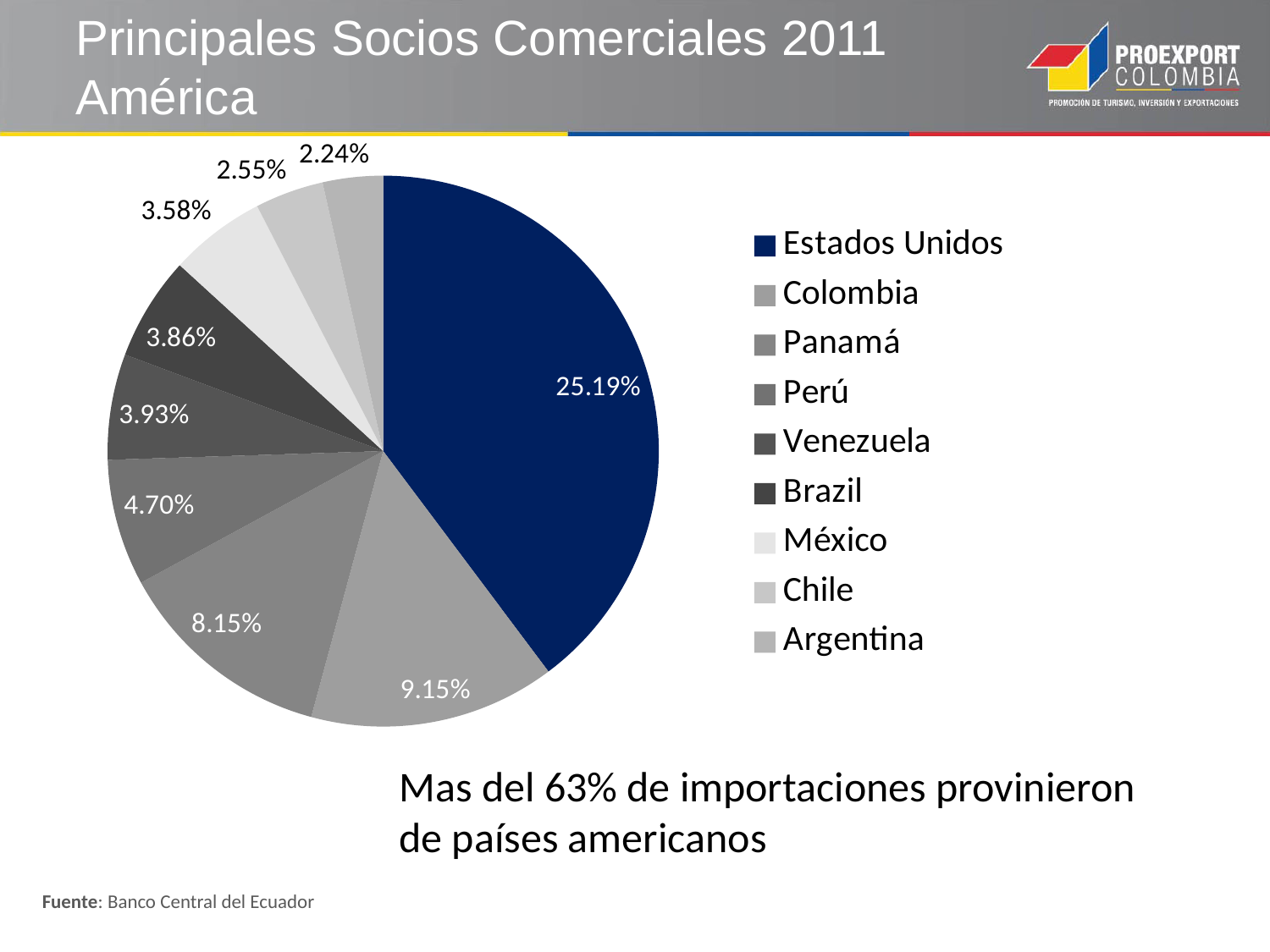
Which country has the smallest slice of the pie? Argentina How many countries are listed in the legend? 9 What is the value shown for Perú? 4.70% What is the value shown for Colombia? 9.15% What is the difference between the shares of Estados Unidos and Colombia? 16.04% What is the value shown for Argentina? 2.24% What is the value shown for Panamá? 8.15% Which has a larger share, Panamá or Perú? Panamá What share of the pie does Estados Unidos have? 25.19% What kind of chart is shown on the slide? pie chart Which country has the largest slice of the pie? Estados Unidos What is the title of the slide containing the chart? Principales Socios Comerciales 2011 América